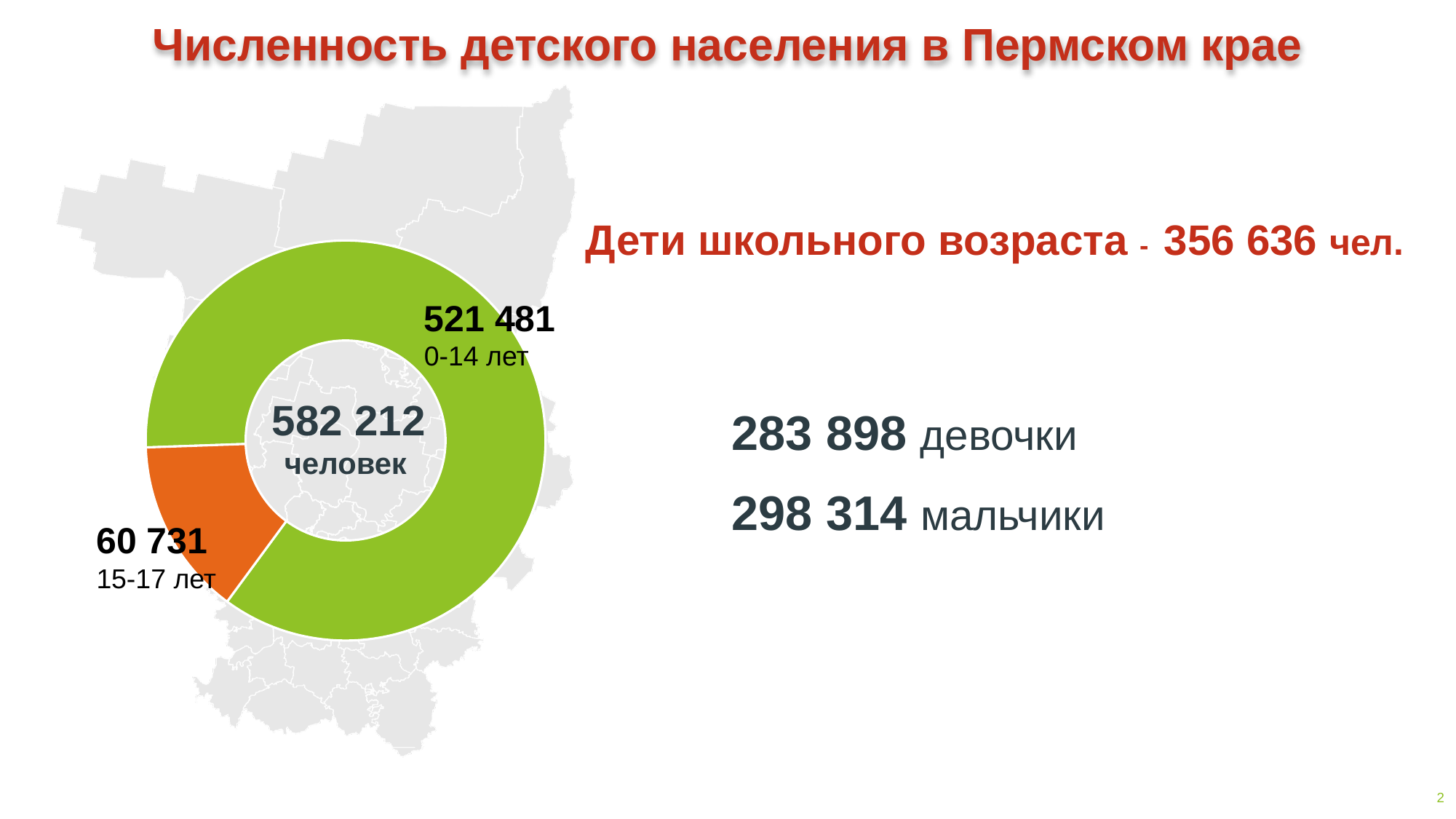
What is the title of the slide containing the donut chart? Численность детского населения в Пермском крае What colour is the 15-17 лет segment of the donut chart? Orange What total is shown in the centre of the donut chart? 582 212 человек What is the value for the 0-14 лет segment of the donut chart? 521 481 Which is larger in the donut chart: the 0-14 лет value or the 15-17 лет value? 0-14 лет What is the difference between the 0-14 лет and 15-17 лет values in the donut chart? 460 750 How many segments does the donut chart have? 2 Which age group has the smallest segment in the donut chart? 15-17 лет What is the value for the 15-17 лет segment of the donut chart? 60 731 Which age group has the largest segment in the donut chart? 0-14 лет What kind of chart is shown on the slide? Donut (pie) chart What share of the total 582 212 does the 15-17 лет segment represent? 10.4%